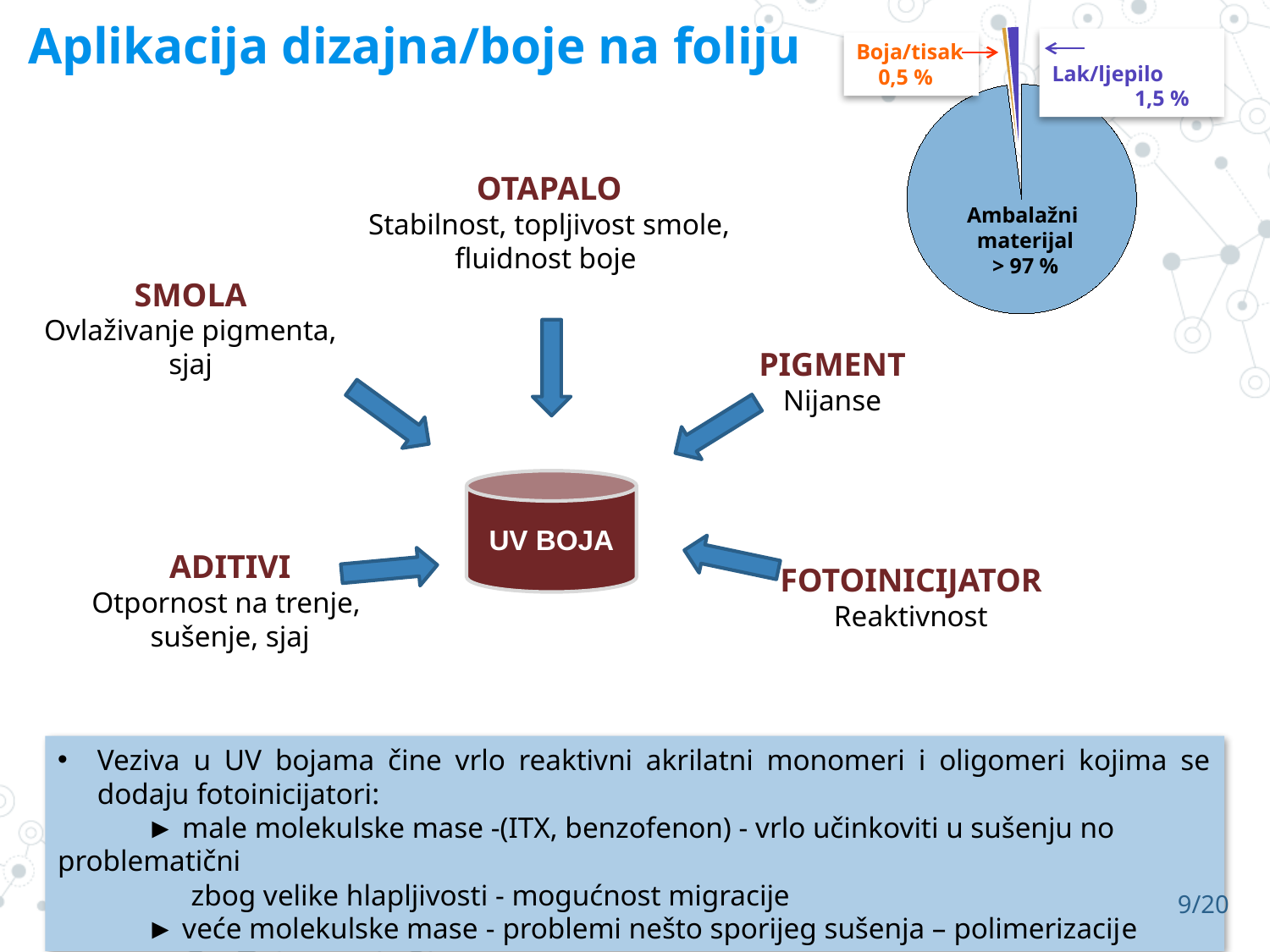
What share of the pie chart is labelled for Lak/ljepilo? 1,5 % What kind of chart is shown in the top right of the slide? pie chart Which slice of the pie chart is the smallest? Boja/tisak What colour is the Ambalažni materijal slice in the pie chart? light blue What is the difference between the Lak/ljepilo and Boja/tisak shares in the pie chart? 1 % In the pie chart, which is larger: Lak/ljepilo or Boja/tisak? Lak/ljepilo What colour is the Boja/tisak label in the pie chart? orange What value is printed for Ambalažni materijal in the pie chart? > 97 % Is the share for Ambalažni materijal in the pie chart greater or less than 90 %? greater What share of the pie chart is labelled for Boja/tisak? 0,5 % Which slice of the pie chart is the largest? Ambalažni materijal How many slices does the pie chart have? 3